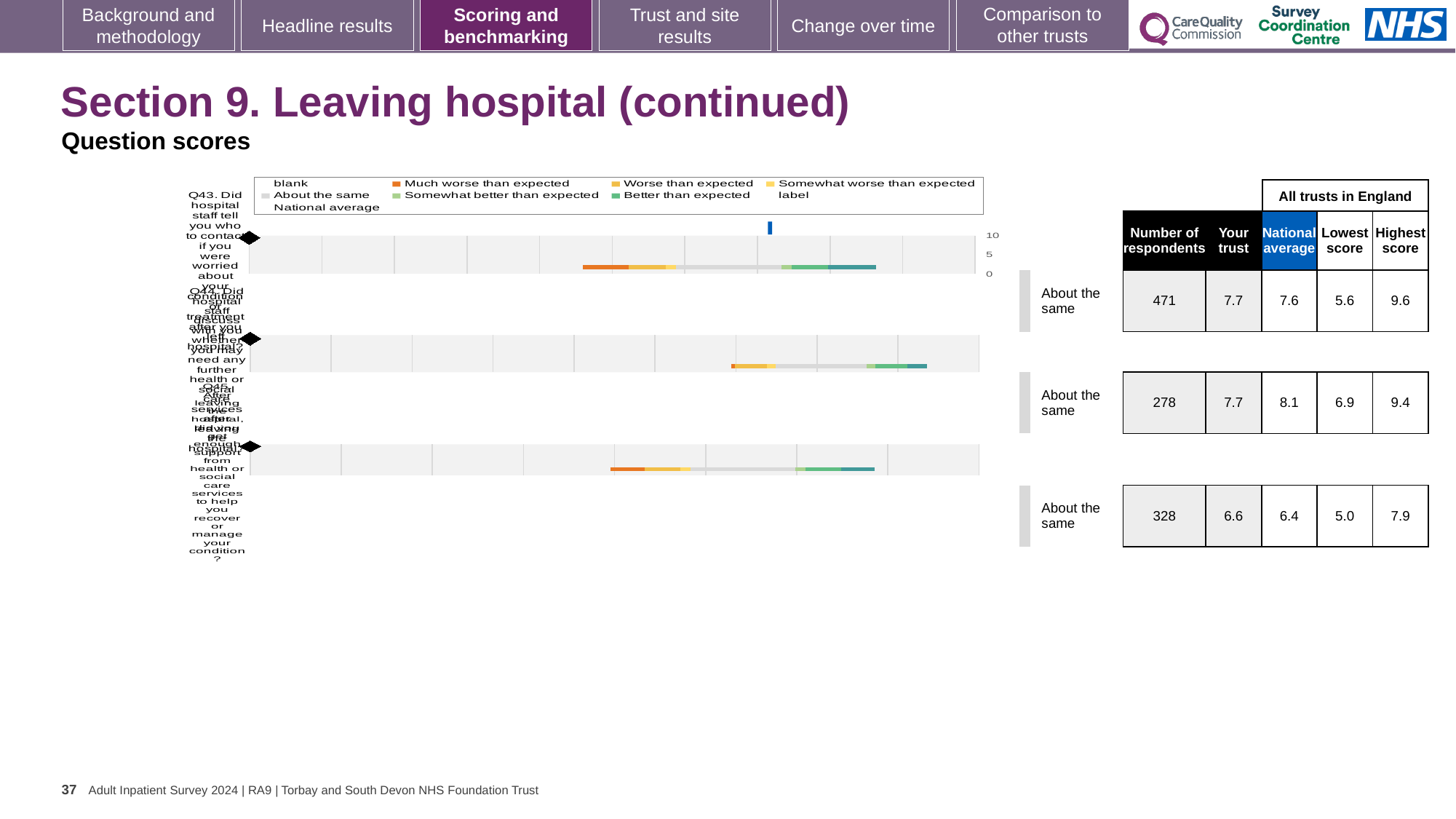
In the table beside the chart, which row has the lowest 'Lowest score' value? the third row (Q45), 5.0 In the table beside the chart, what is the number of respondents for the first row (Q43)? 471 In the chart legend, which colour represents 'Much worse than expected'? orange In the table beside the chart, what is the 'Your trust' score for the second row (Q44)? 7.7 In the table beside the chart, what is the national average for the third row (Q45)? 6.4 In the table beside the chart, what is the difference between the national average and the 'Your trust' score for the second row (Q44)? 0.4 In the table beside the chart, is the 'Your trust' score for the third row (Q45) larger or smaller than its national average? larger How many question rows (bars) does the chart show? 3 In the table beside the chart, which row has the fewest respondents? the second row (Q44), 278 What kind of chart is shown on the slide? bar chart What is the rating shown next to each of the three bars in the chart? About the same In the table beside the chart, which row has the highest 'Highest score' value? the first row (Q43), 9.6